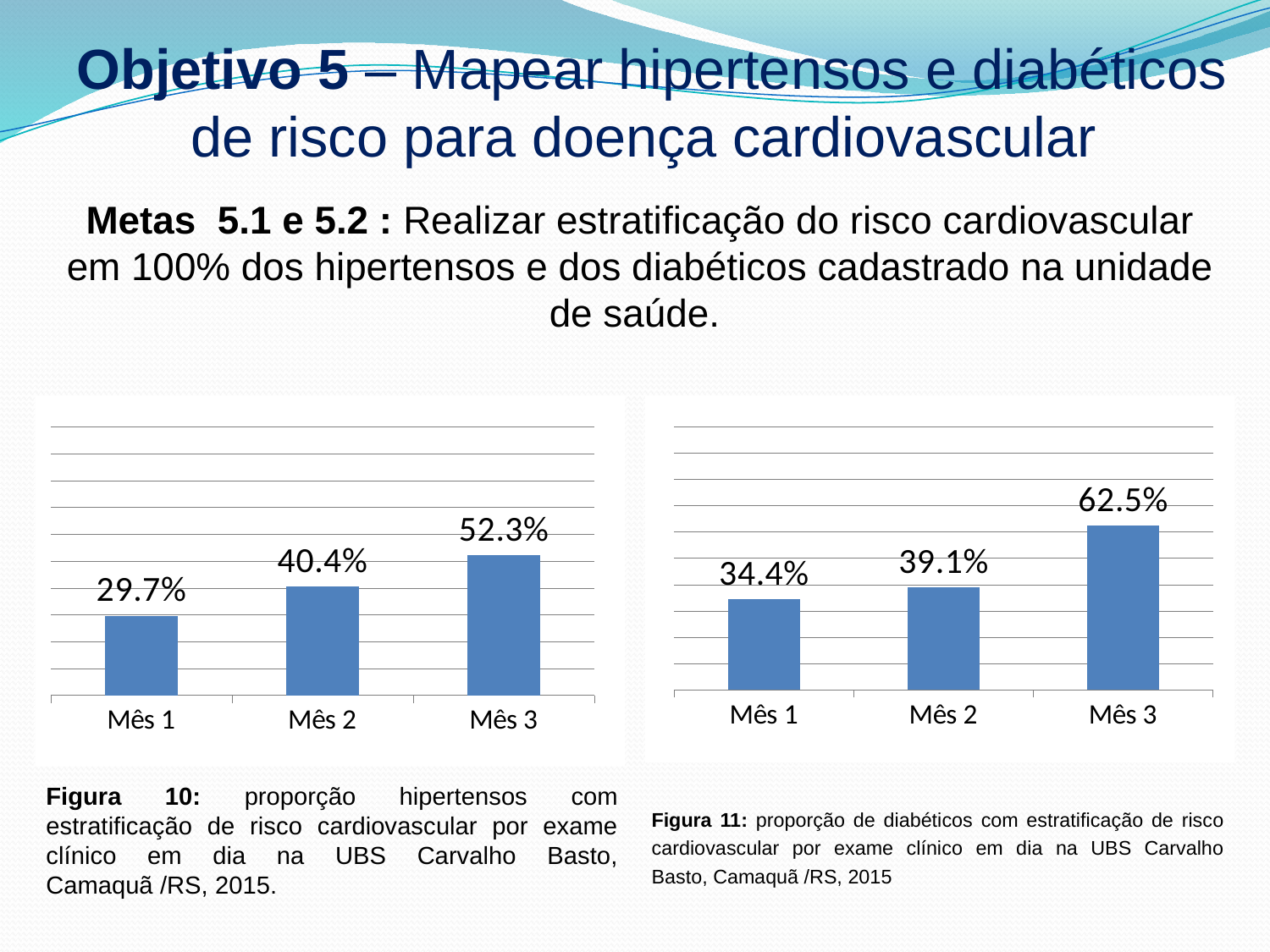
In the right chart (Figura 11), what is the value for Mês 3? 62.5% In the left chart (Figura 10), what is the value for Mês 1? 29.7% In the right chart (Figura 11), do the values rise or fall from Mês 1 to Mês 3? Rise In the right chart (Figura 11), what is the value for Mês 1? 34.4% In the right chart (Figura 11), what is the difference between the values for Mês 3 and Mês 2? 23.4% In the right chart (Figura 11), which month has the lowest value? Mês 1 In the left chart (Figura 10), what is the difference between the values for Mês 3 and Mês 1? 22.6% In the left chart (Figura 10), which month has the highest value? Mês 3 How many months are shown on the x axis of the right chart (Figura 11)? 3 In the left chart (Figura 10), what is the value for Mês 2? 40.4% Which is larger: the Mês 2 value in the left chart (Figura 10) or the Mês 2 value in the right chart (Figura 11)? Left chart (Figura 10), 40.4% What type of chart is the left chart (Figura 10)? Bar chart